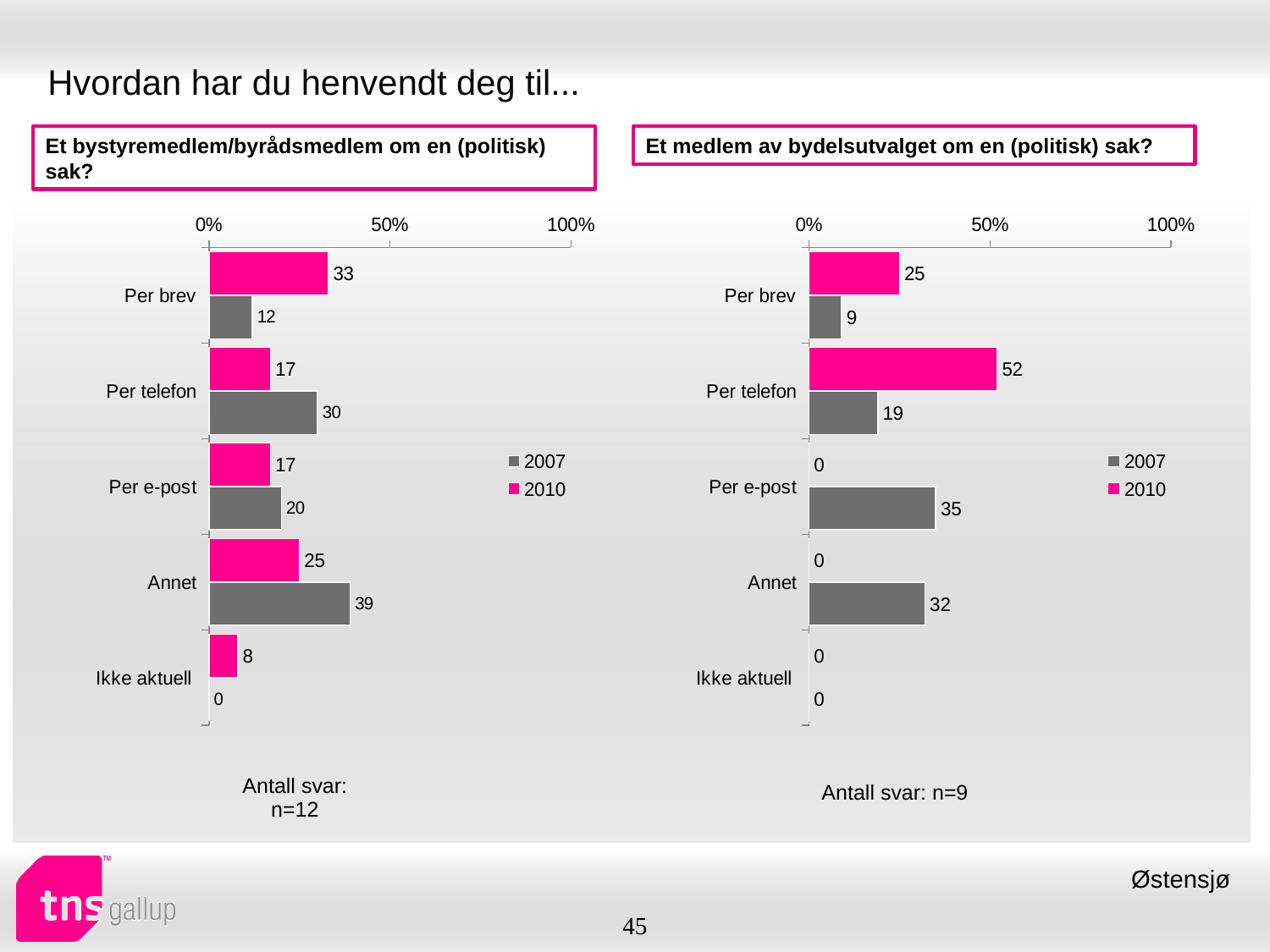
In the right chart (Et medlem av bydelsutvalget om en (politisk) sak?), is the 2007 value for Annet larger or the 2007 value for Per brev? Annet In the left chart (Et bystyremedlem/byrådsmedlem om en (politisk) sak?), what is the difference between the 2007 and 2010 values for Per telefon? 13 In the left chart (Et bystyremedlem/byrådsmedlem om en (politisk) sak?), what is the value for Per brev in 2010? 33 How many series does the legend of the left chart list? 2 In the left chart (Et bystyremedlem/byrådsmedlem om en (politisk) sak?), what is the value for Annet in 2007? 39 In the left chart (Et bystyremedlem/byrådsmedlem om en (politisk) sak?), which category has the highest value for 2007? Annet In the right chart (Et medlem av bydelsutvalget om en (politisk) sak?), what is the value for Per telefon in 2010? 52 In the right chart (Et medlem av bydelsutvalget om en (politisk) sak?), which category has the highest value for 2010? Per telefon In the left chart (Et bystyremedlem/byrådsmedlem om en (politisk) sak?), how many categories are shown? 5 In the right chart (Et medlem av bydelsutvalget om en (politisk) sak?), is the 2010 value for Per telefon greater or less than 50%? greater What type of chart is the right chart (Et medlem av bydelsutvalget om en (politisk) sak?)? Bar chart In the right chart (Et medlem av bydelsutvalget om en (politisk) sak?), what is the value for Per e-post in 2007? 35